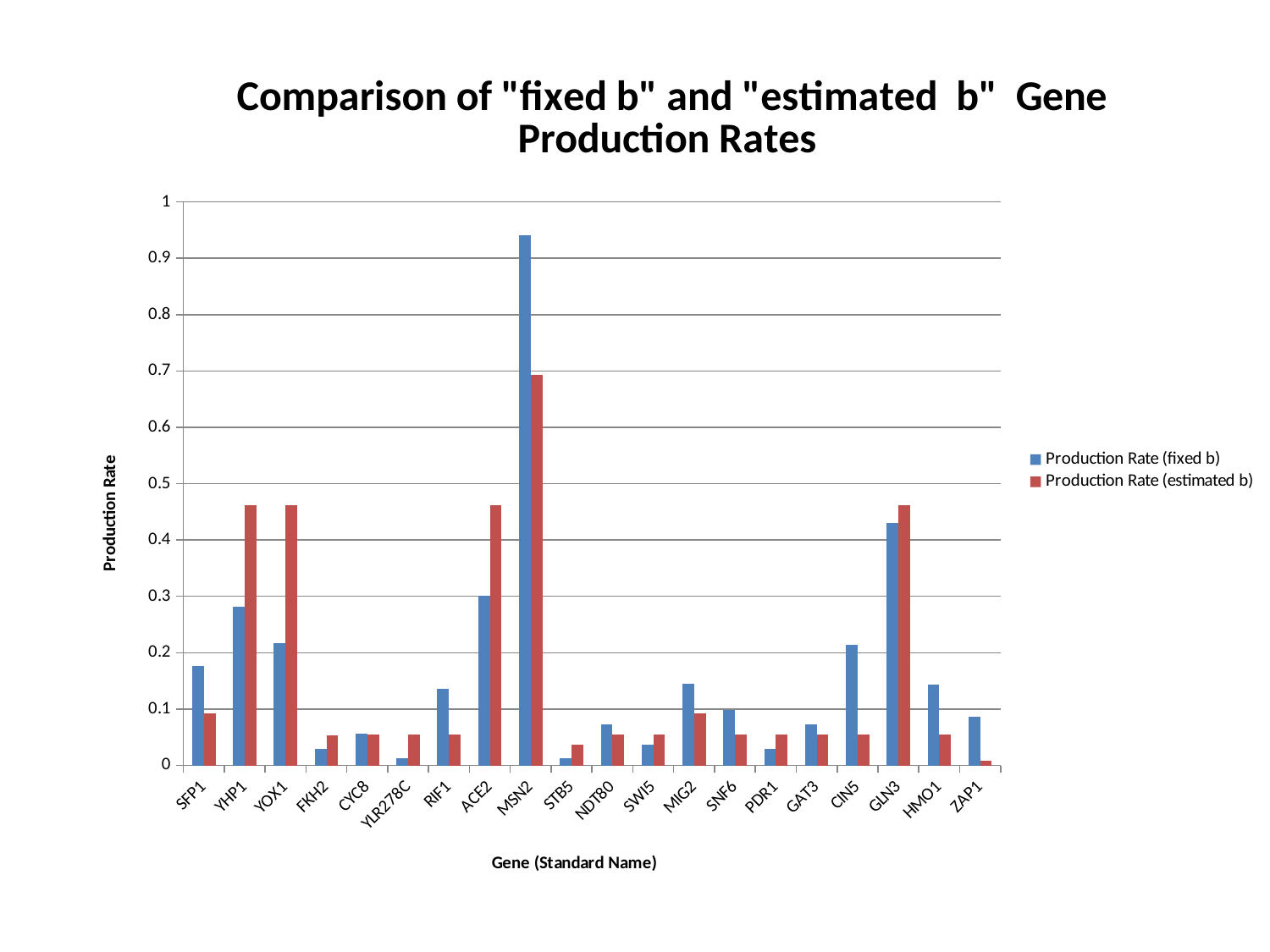
Which gene has the highest Production Rate (fixed b)? MSN2 Which gene has the highest Production Rate (estimated b)? MSN2 Is the Production Rate (fixed b) for MSN2 greater or less than 0.9? greater Is the Production Rate (estimated b) for ZAP1 greater or less than 0.1? less Is the Production Rate (estimated b) for YHP1 greater or less than 0.4? greater For YOX1, which is larger: Production Rate (fixed b) or Production Rate (estimated b)? Production Rate (estimated b) How many series does the legend list? 2 Which gene has the lowest Production Rate (estimated b)? ZAP1 For CIN5, which is larger: Production Rate (fixed b) or Production Rate (estimated b)? Production Rate (fixed b) What kind of chart is shown on the slide? bar chart What is the label of the x axis? Gene (Standard Name) How many genes are shown on the x axis? 20